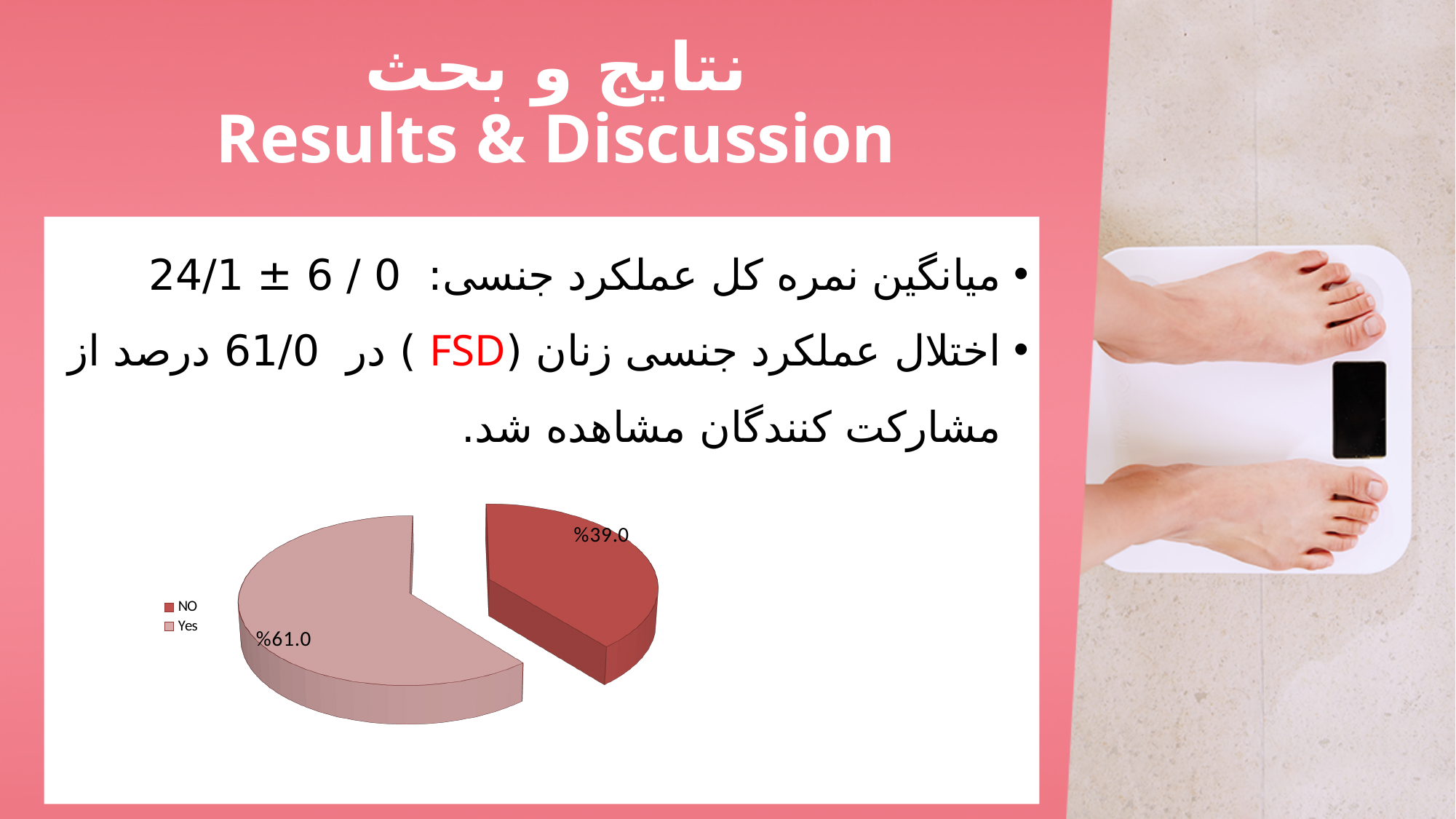
Is the value for the "Yes" slice greater or less than 50%? greater Which is larger, the "Yes" slice or the "NO" slice? Yes What is the difference in percentage points between the "Yes" slice and the "NO" slice? 22.0 What kind of chart is shown on the slide? pie chart What share of the pie does the "NO" slice represent? %39.0 Which legend entry is shown in the darker red colour? NO Which slice of the pie is the smallest? NO Which slice of the pie is the largest? Yes How many slices does the pie chart have? 2 What share of the pie does the "Yes" slice represent? %61.0 How many entries does the legend list? 2 Which slice is pulled out (exploded) from the rest of the pie? NO